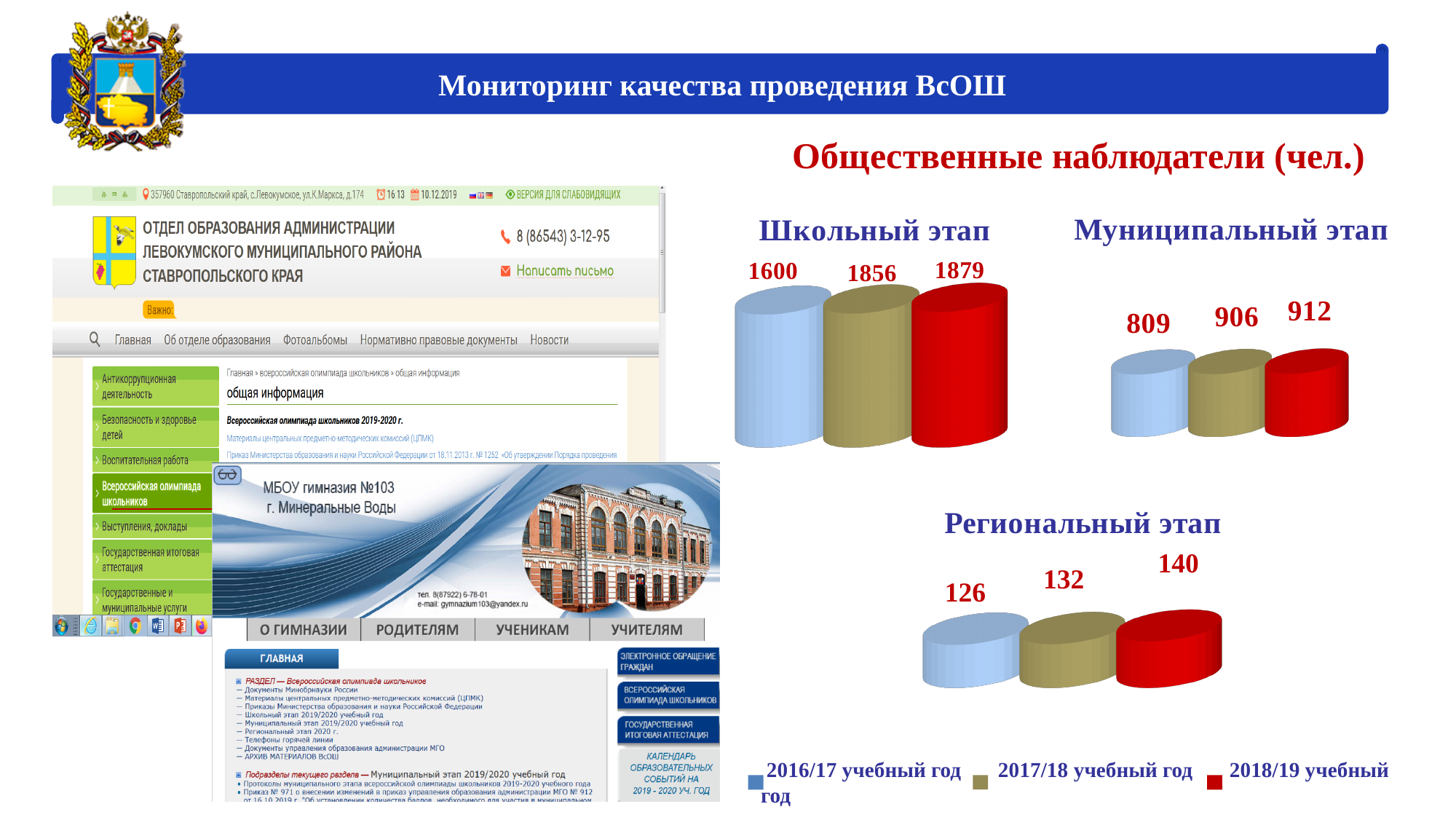
In the 'Муниципальный этап' chart, what is the value for 2018/19 учебный год? 912 In the 'Школьный этап' chart, what is the value for 2016/17 учебный год? 1600 How many bars are shown in the 'Региональный этап' chart? 3 In the 'Региональный этап' chart, what is the value for 2017/18 учебный год? 132 In the 'Школьный этап' chart, what is the difference between the values for 2017/18 and 2016/17? 256 In the 'Школьный этап' chart, which year has the highest value? 2018/19 учебный год In the 'Муниципальный этап' chart, which year has the lowest value? 2016/17 учебный год How many series does the legend list for the charts? 3 In the 'Региональный этап' chart, what is the difference between the values for 2018/19 and 2016/17? 14 In the 'Региональный этап' chart, do the values rise or fall from 2016/17 to 2018/19? rise In the 'Муниципальный этап' chart, which is larger: the value for 2016/17 or the value for 2017/18? 2017/18 What kind of chart is the 'Школьный этап' chart? bar chart